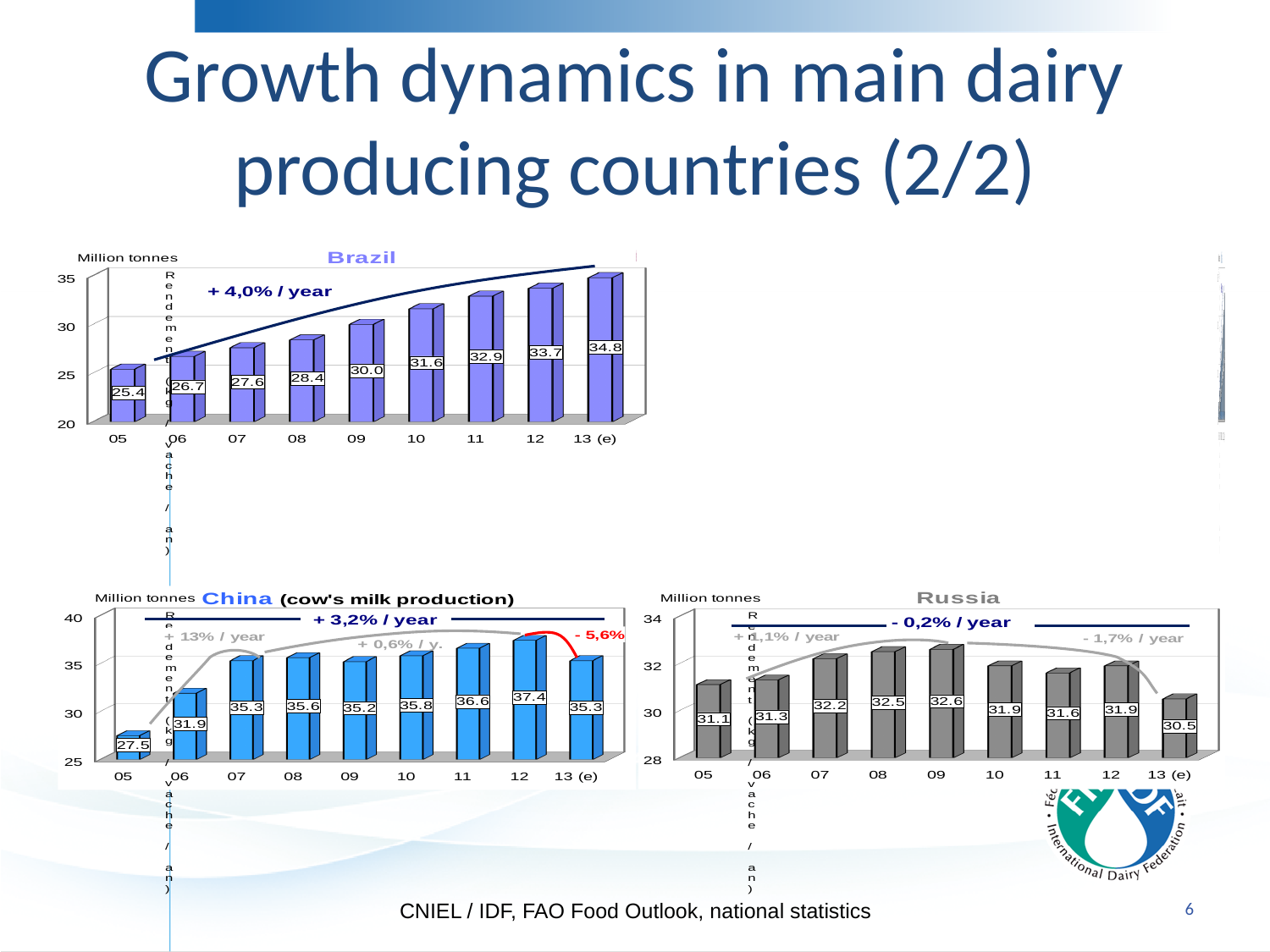
In the China chart, what is the value for 05? 27.5 In the Russia chart, what is the value for 09? 32.6 What annual growth rate is printed on the Brazil chart? + 4,0% / year In the China chart, which is larger, the value for 12 or the value for 13 (e)? 12 What kind of chart is the Russia chart? bar chart How many years are plotted in the Brazil chart? 9 In the Brazil chart, what is the difference between the values for 13 (e) and 05? 9.4 In the Russia chart, what is the difference between the values for 09 and 13 (e)? 2.1 In the Brazil chart, what is the value for 13 (e)? 34.8 In the China chart, which year has the highest value? 12 In the Russia chart, which year has the lowest value? 13 (e) In the Brazil chart, do the values rise or fall from 05 to 13 (e)? rise